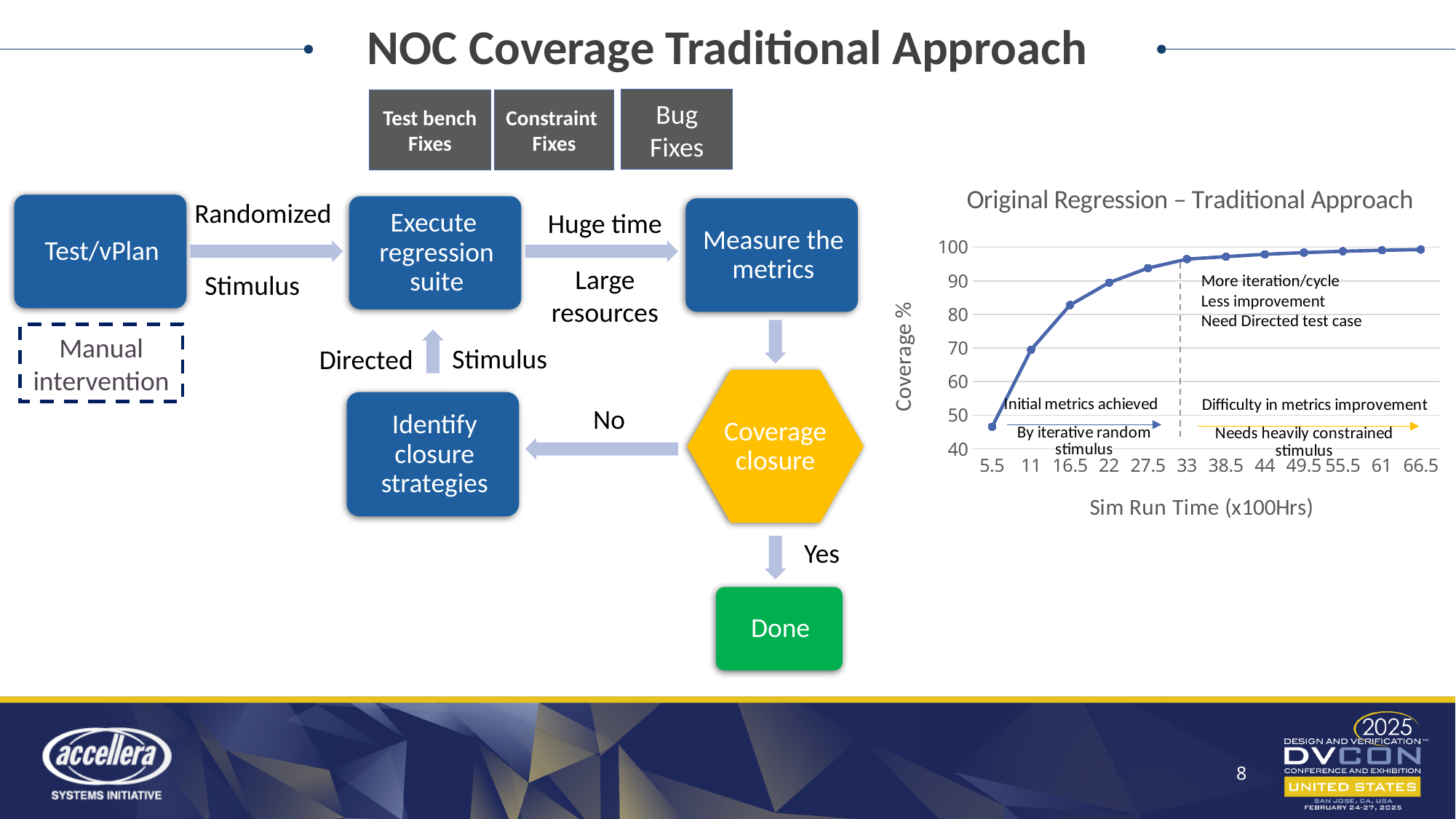
Is the coverage value at sim run time 11 greater or less than 80? less How many data points are plotted on the line in the chart? 12 Does coverage rise or fall as sim run time increases along the x axis? rises Is the coverage value at sim run time 5.5 greater or less than 50? less What is the title of the chart on the slide? Original Regression – Traditional Approach Is the coverage value at sim run time 66.5 greater or less than 90? greater What is the label of the x axis of the chart? Sim Run Time (x100Hrs) What kind of chart is shown on the slide? line chart At which sim run time is the coverage lowest? 5.5 Which has the higher coverage: sim run time 11 or sim run time 27.5? 27.5